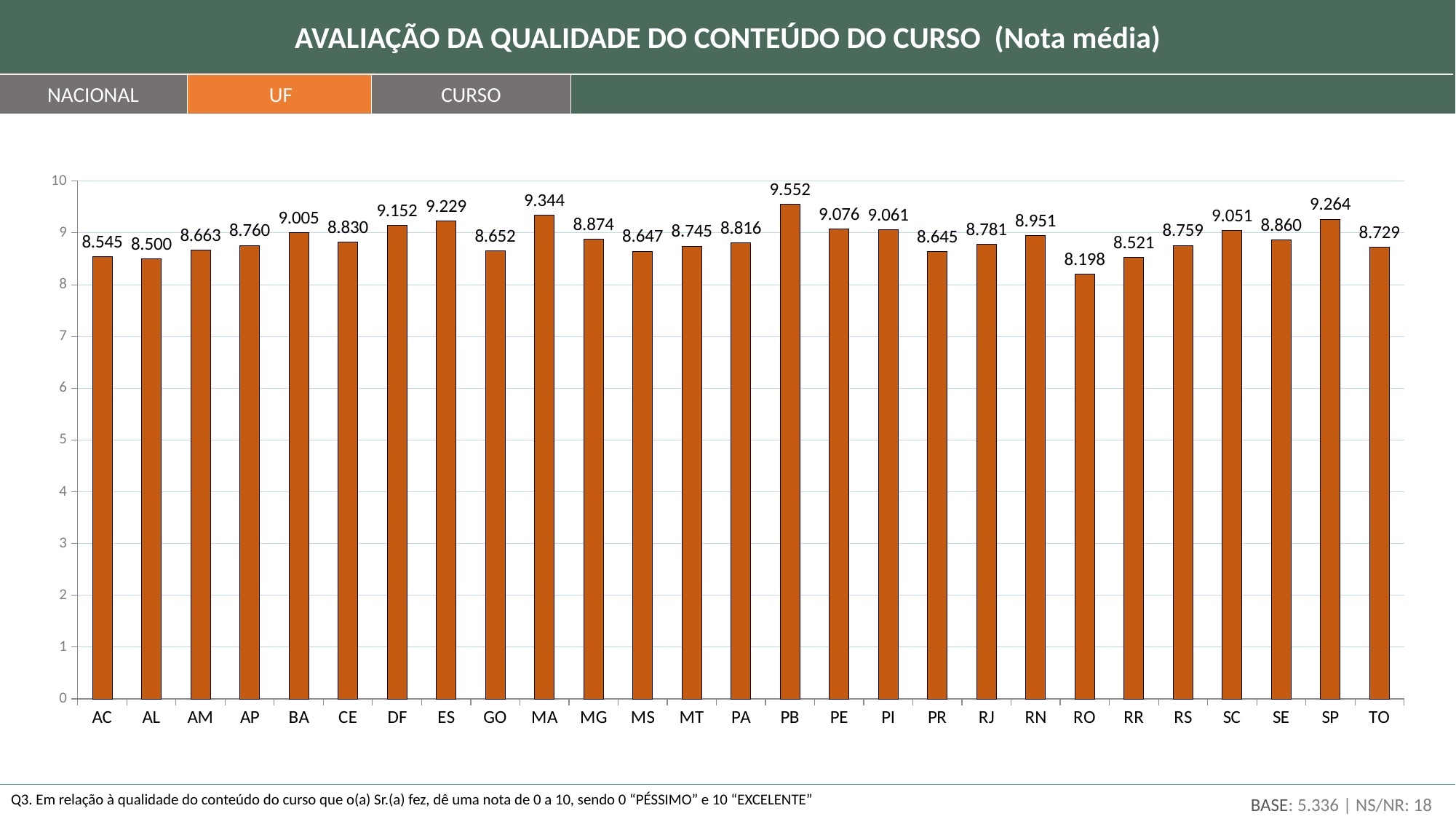
What is the difference between the scores of PB and RO? 1.354 What is the difference between the scores of MA and SP? 0.080 What is the average score (nota média) for PB? 9.552 How many UFs (categories) are shown on the x axis? 27 Which UF has the lowest average score? RO Is the value for RO greater or less than 9? less What is the value plotted for SP? 9.264 Which UF has the highest average score? PB Which has a higher score, DF or ES? ES What kind of chart is shown on the slide? bar chart What is the average score shown for RO? 8.198 What is the title of the chart? AVALIAÇÃO DA QUALIDADE DO CONTEÚDO DO CURSO (Nota média)